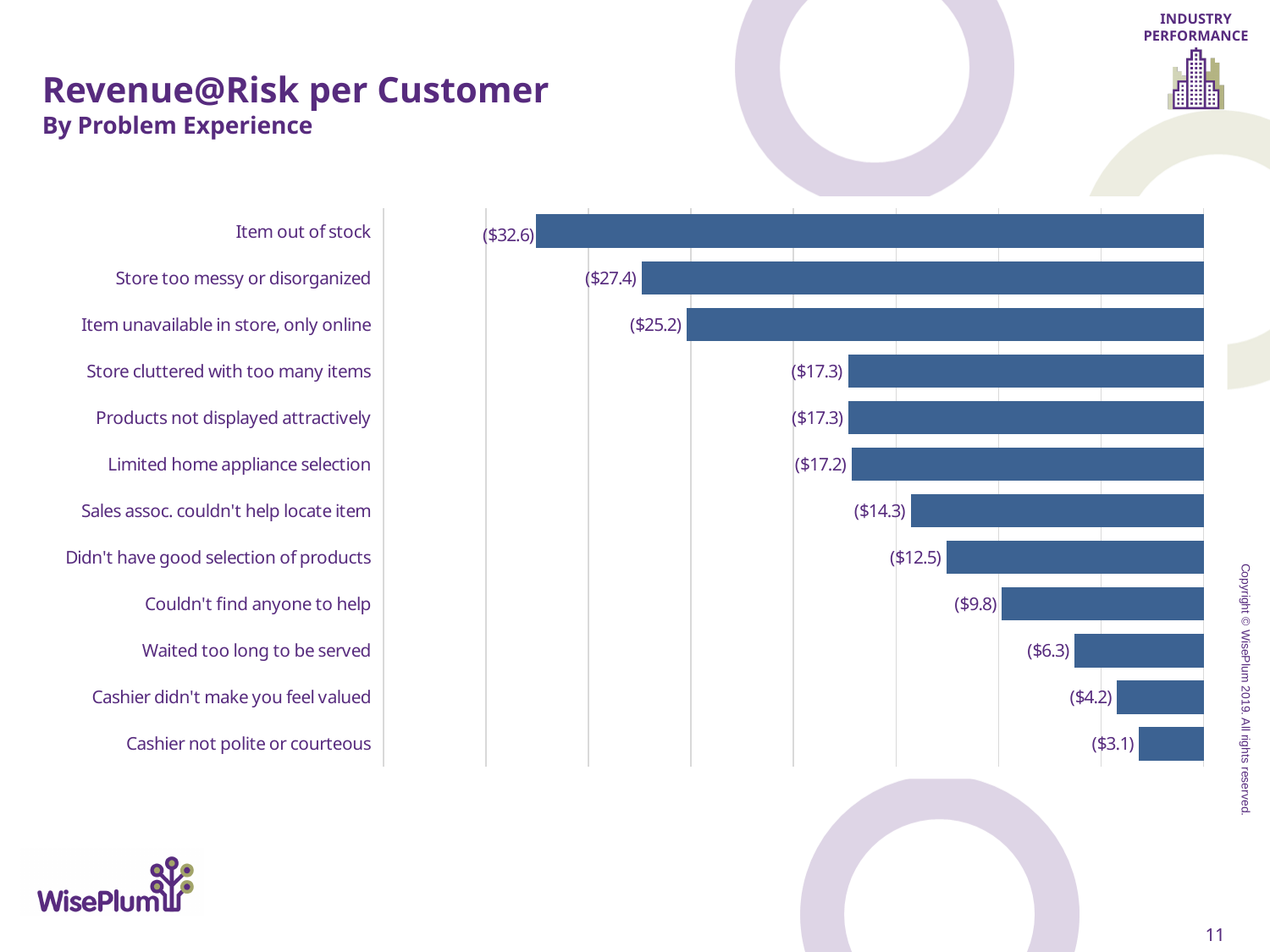
Which problem experience has the largest Revenue@Risk per Customer (the longest bar)? Item out of stock Which has the larger Revenue@Risk magnitude: 'Item unavailable in store, only online' or 'Limited home appliance selection'? Item unavailable in store, only online What value is shown for 'Waited too long to be served'? ($6.3) What is the Revenue@Risk per Customer value shown for 'Item out of stock'? ($32.6) What value is shown for 'Didn't have good selection of products'? ($12.5) What type of chart is shown on the slide? Bar chart What is the difference in magnitude between the values for 'Couldn't find anyone to help' and 'Cashier didn't make you feel valued'? $5.6 By how much does the Revenue@Risk for 'Item out of stock' exceed that for 'Store too messy or disorganized' in magnitude? $5.2 How many problem experience categories are plotted on the chart? 12 What is the subtitle of the chart below 'Revenue@Risk per Customer'? By Problem Experience Which problem experience has the smallest Revenue@Risk per Customer (the shortest bar)? Cashier not polite or courteous What value is labelled on the bar for 'Sales assoc. couldn't help locate item'? ($14.3)